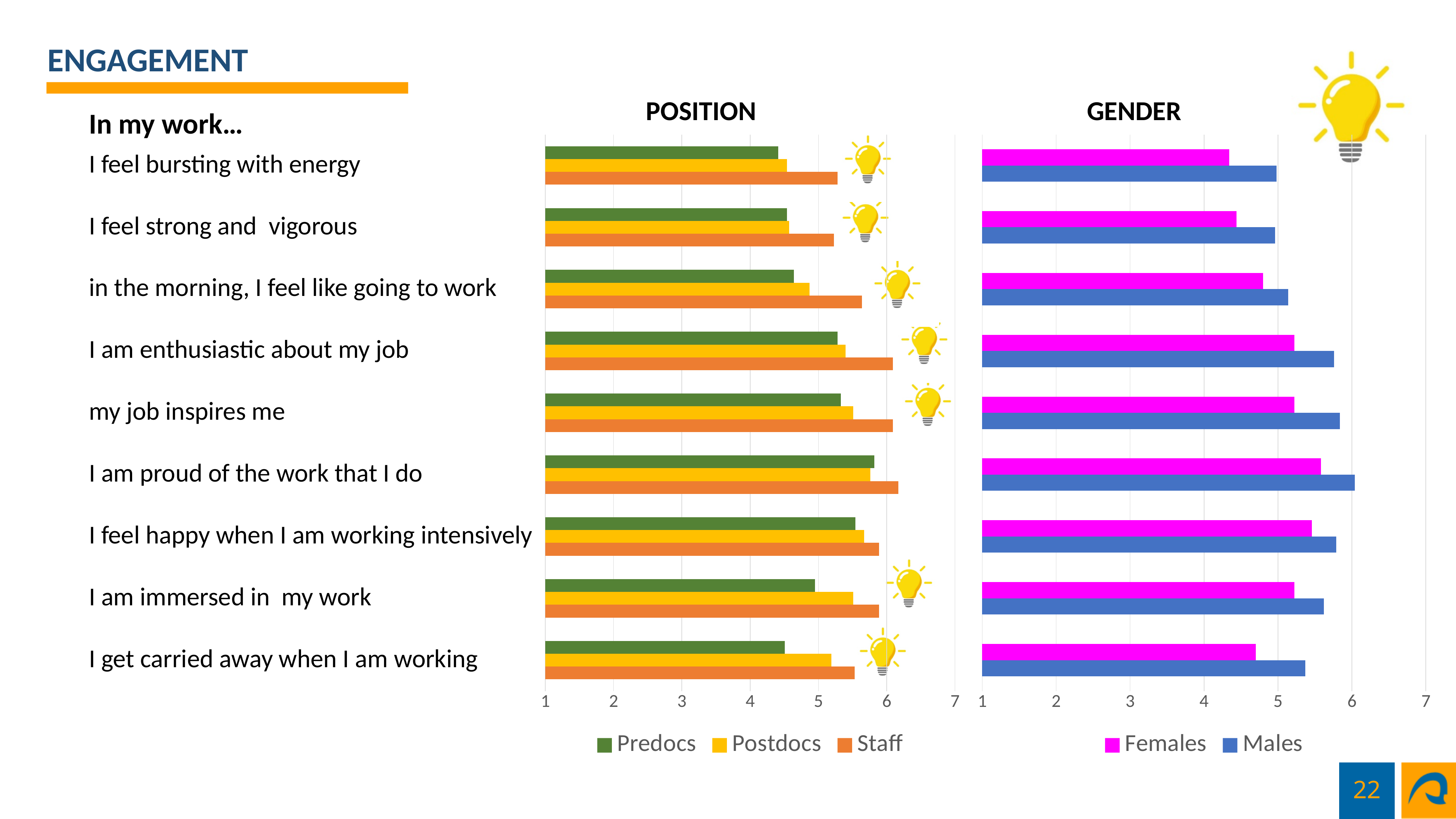
How many series does the legend of the GENDER chart list? 2 In the GENDER chart, is the Females value for 'I am proud of the work that I do' greater or less than 5? greater In the POSITION chart, which is larger for 'I feel bursting with energy', the Predocs value or the Staff value? Staff In the POSITION chart, is the Predocs value for 'I feel bursting with energy' greater or less than 5? less In the GENDER chart, for which statement is the Males value highest? I am proud of the work that I do In the GENDER chart, which is larger for 'I am proud of the work that I do', Females or Males? Males In the GENDER chart, is the Females value for 'I get carried away when I am working' greater or less than 5? less What kind of chart is the POSITION chart? bar chart How many statements (categories) are plotted in the GENDER chart? 9 Which series in the POSITION chart is shown in green? Predocs How many series does the legend of the POSITION chart list? 3